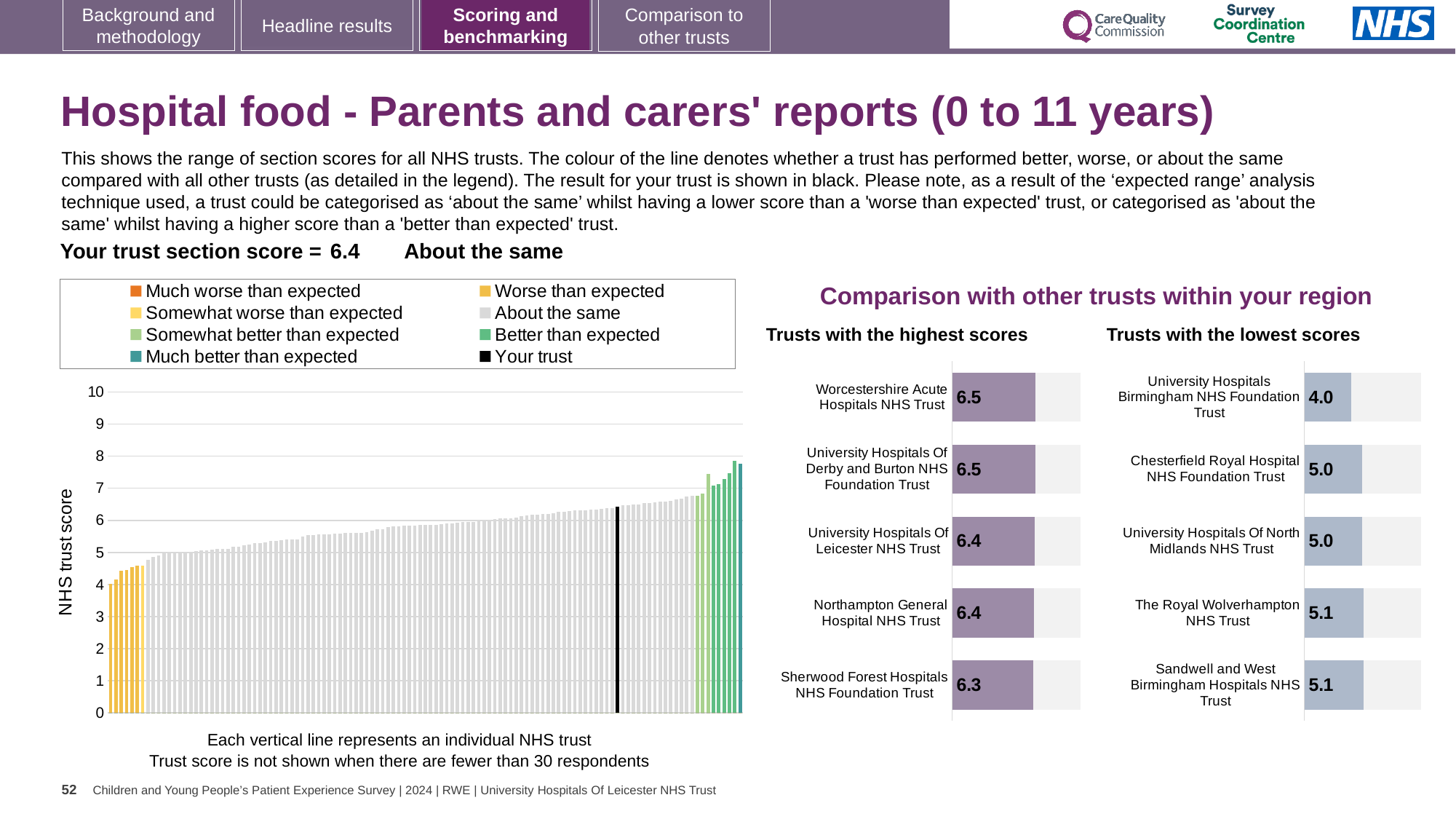
In the 'Trusts with the highest scores' chart, what is the difference between the scores of Worcestershire Acute Hospitals NHS Trust and Sherwood Forest Hospitals NHS Foundation Trust? 0.2 In the 'Trusts with the lowest scores' chart, what is the difference between the scores of Sandwell and West Birmingham Hospitals NHS Trust and University Hospitals Birmingham NHS Foundation Trust? 1.1 In the large chart on the left, is the value of the lowest bar greater or less than 5? less How many entries does the legend of the large chart on the left list? 8 In the 'Trusts with the lowest scores' chart, what is the score for University Hospitals Birmingham NHS Foundation Trust? 4.0 How many trusts are listed in the 'Trusts with the highest scores' chart? 5 In the 'Trusts with the highest scores' chart, what is the score for Worcestershire Acute Hospitals NHS Trust? 6.5 In the large chart on the left, is the value of the highest bar greater or less than 7? greater In the 'Trusts with the lowest scores' chart, which has the larger score: Chesterfield Royal Hospital NHS Foundation Trust or University Hospitals Birmingham NHS Foundation Trust? Chesterfield Royal Hospital NHS Foundation Trust In the 'Trusts with the highest scores' chart, what is the score for Sherwood Forest Hospitals NHS Foundation Trust? 6.3 In the 'Trusts with the lowest scores' chart, which trust has the lowest score? University Hospitals Birmingham NHS Foundation Trust In the large chart on the left, do the bar values rise or fall from left to right? rise